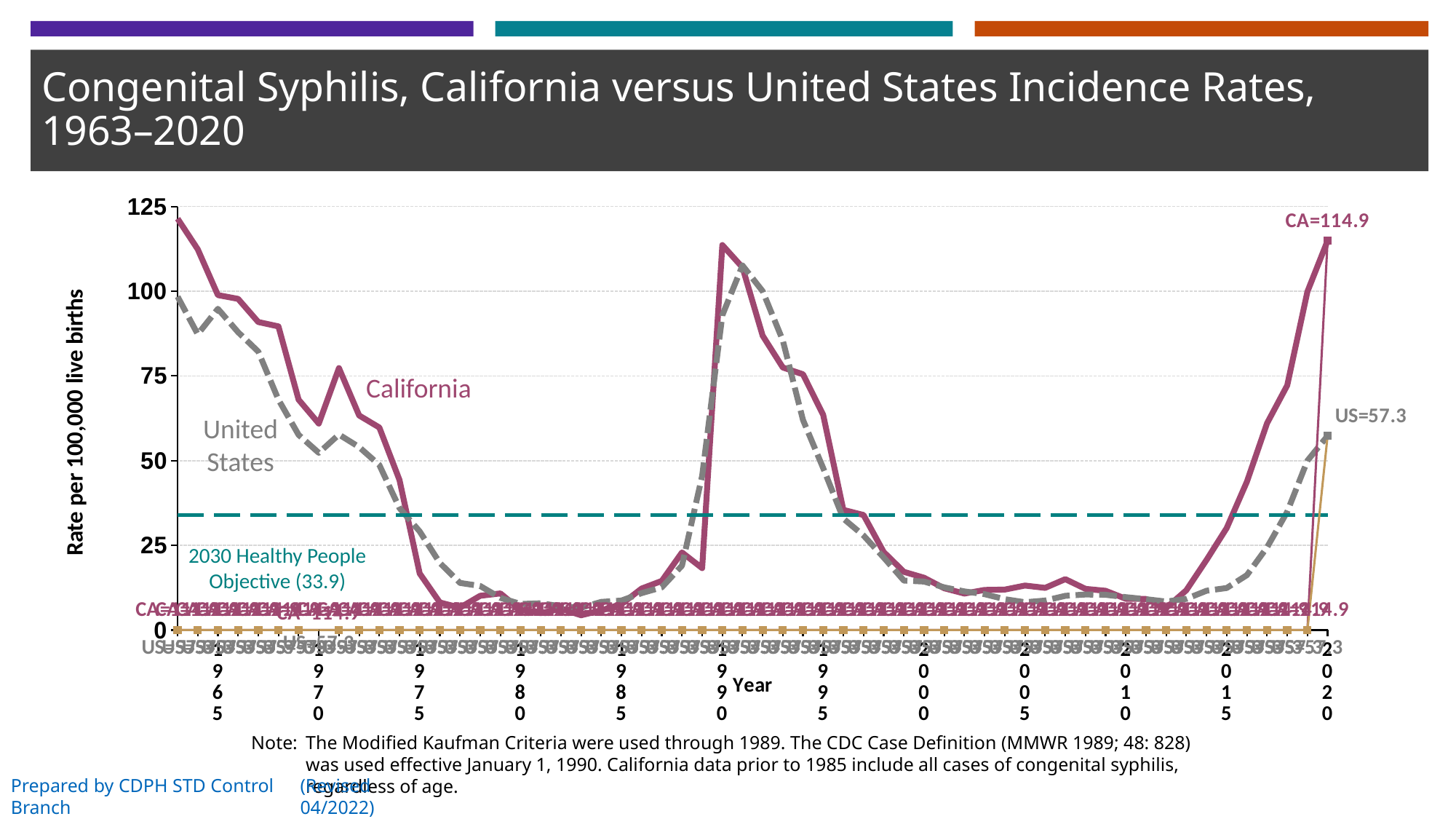
Is the United States rate in 2005 greater or less than 25? less What is the difference between the California and United States rates in 2020? 57.6 In 2020, which has the higher rate, California or the United States? California What kind of chart is shown on the slide? line chart Is the California rate in 2010 greater or less than 25? less What is the label on the y axis of the chart? Rate per 100,000 live births What is the California congenital syphilis rate in 2020? 114.9 Is the California rate in 1980 greater or less than 25? less Which series is drawn as a gray dashed line? United States What is the value of the 2030 Healthy People Objective shown on the chart? 33.9 Does the California rate rise or fall between 2015 and 2020? rise What is the United States congenital syphilis rate in 2020? 57.3